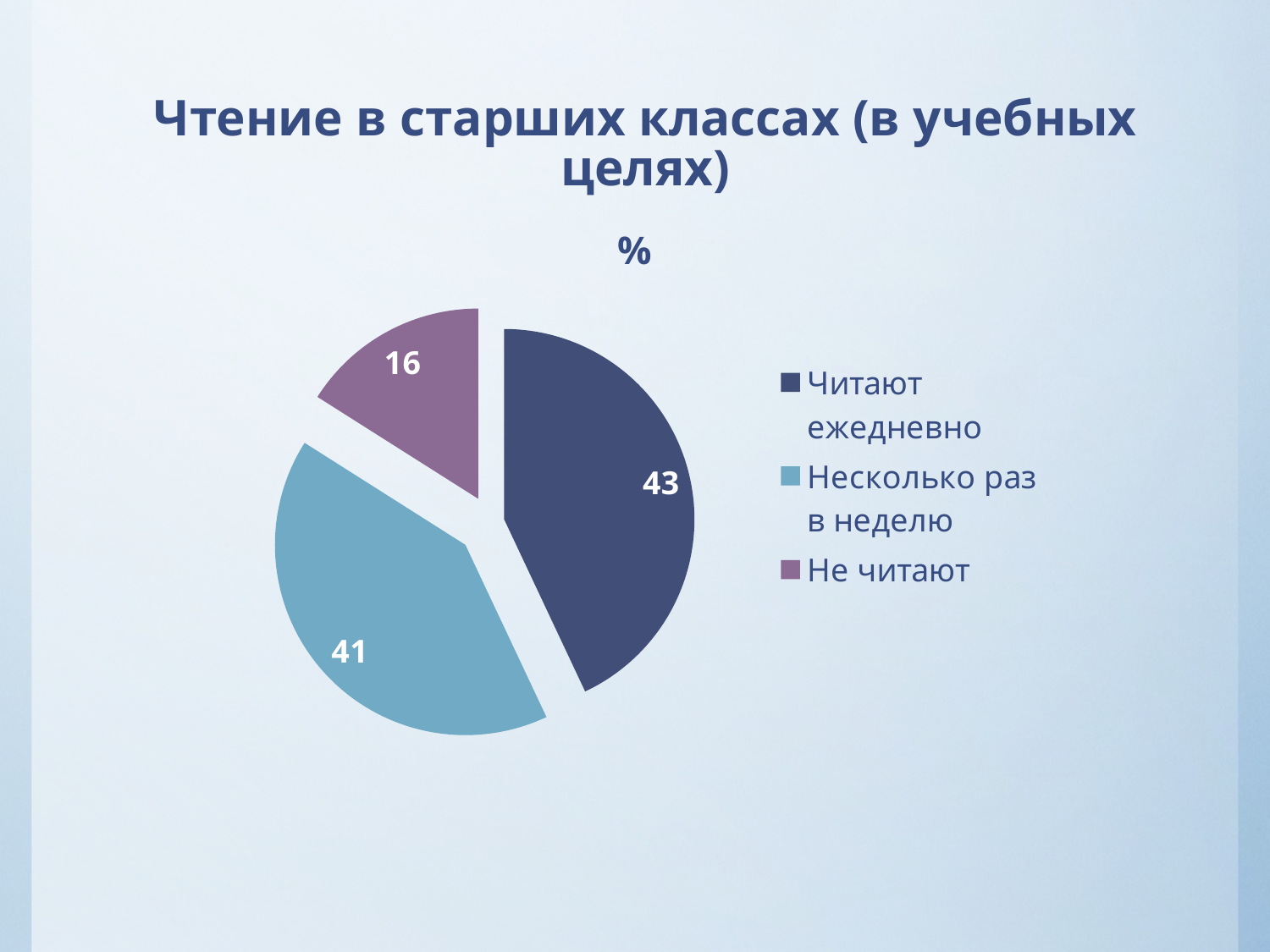
What is the difference between the values for Читают ежедневно and Не читают? 27 What is the value for Не читают? 16 How many slices does the pie chart have? 3 What is the title of the chart? % What type of chart is shown on the slide? pie chart Which is larger, the value for Читают ежедневно or the value for Несколько раз в неделю? Читают ежедневно What colour is the slice for Не читают? purple Which category has the largest slice? Читают ежедневно What is the value for Несколько раз в неделю? 41 What is the difference between the values for Несколько раз в неделю and Не читают? 25 Which category has the smallest slice? Не читают What is the value for Читают ежедневно? 43